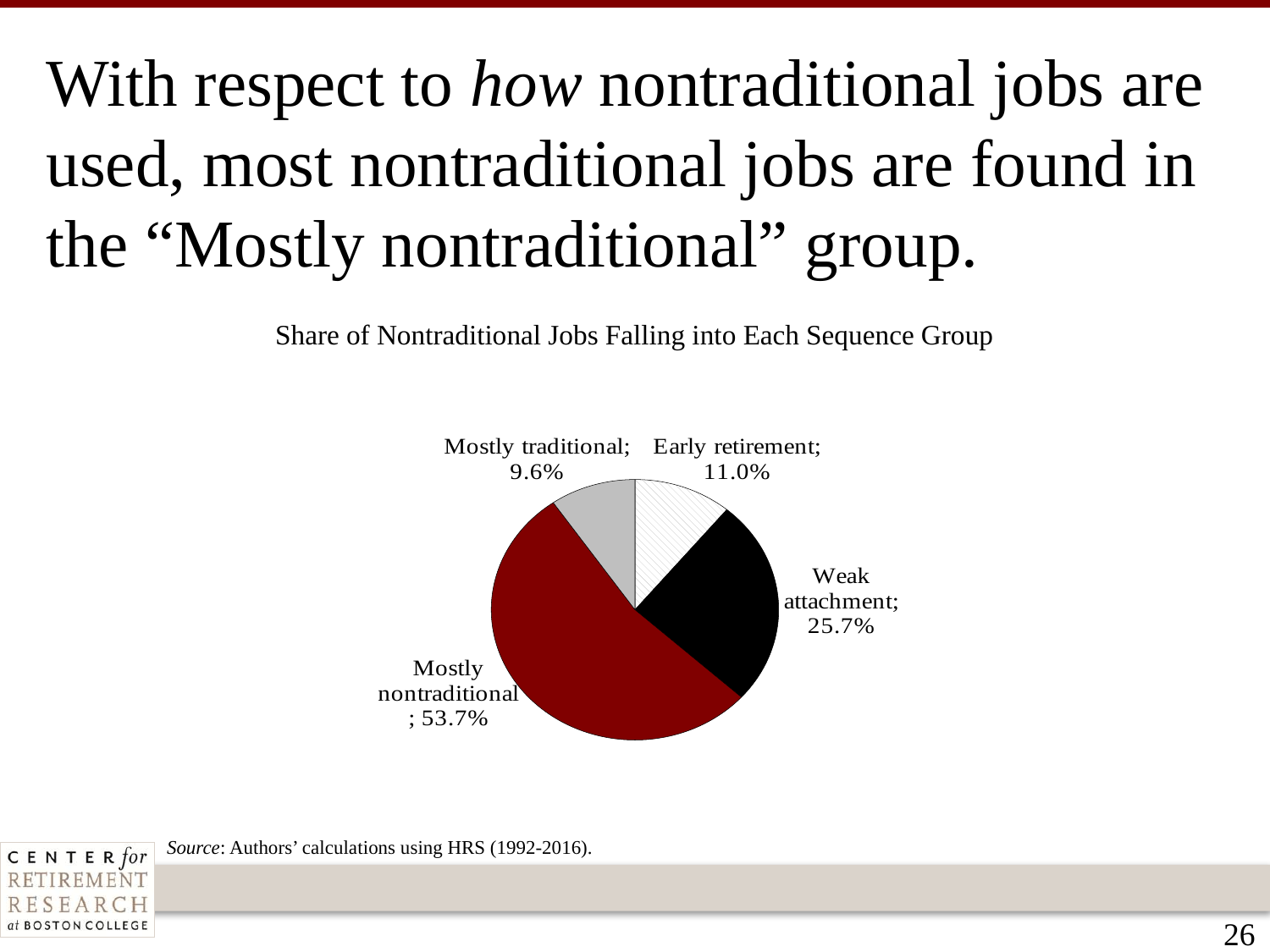
What share of nontraditional jobs falls into the Mostly traditional group? 9.6% What share of nontraditional jobs falls into the Early retirement group? 11.0% Which sequence group has the smallest share of nontraditional jobs? Mostly traditional Which sequence group has the largest share of nontraditional jobs? Mostly nontraditional Which group has a larger share, Weak attachment or Early retirement? Weak attachment What share of nontraditional jobs falls into the Mostly nontraditional group? 53.7% What type of chart is shown on the slide? Pie chart How many sequence groups are shown in the pie chart? 4 What is the difference in share between the Early retirement and Mostly traditional groups? 1.4% What is the difference in share between the Mostly nontraditional and Weak attachment groups? 28.0% What share of nontraditional jobs falls into the Weak attachment group? 25.7% What is the title of the chart? Share of Nontraditional Jobs Falling into Each Sequence Group